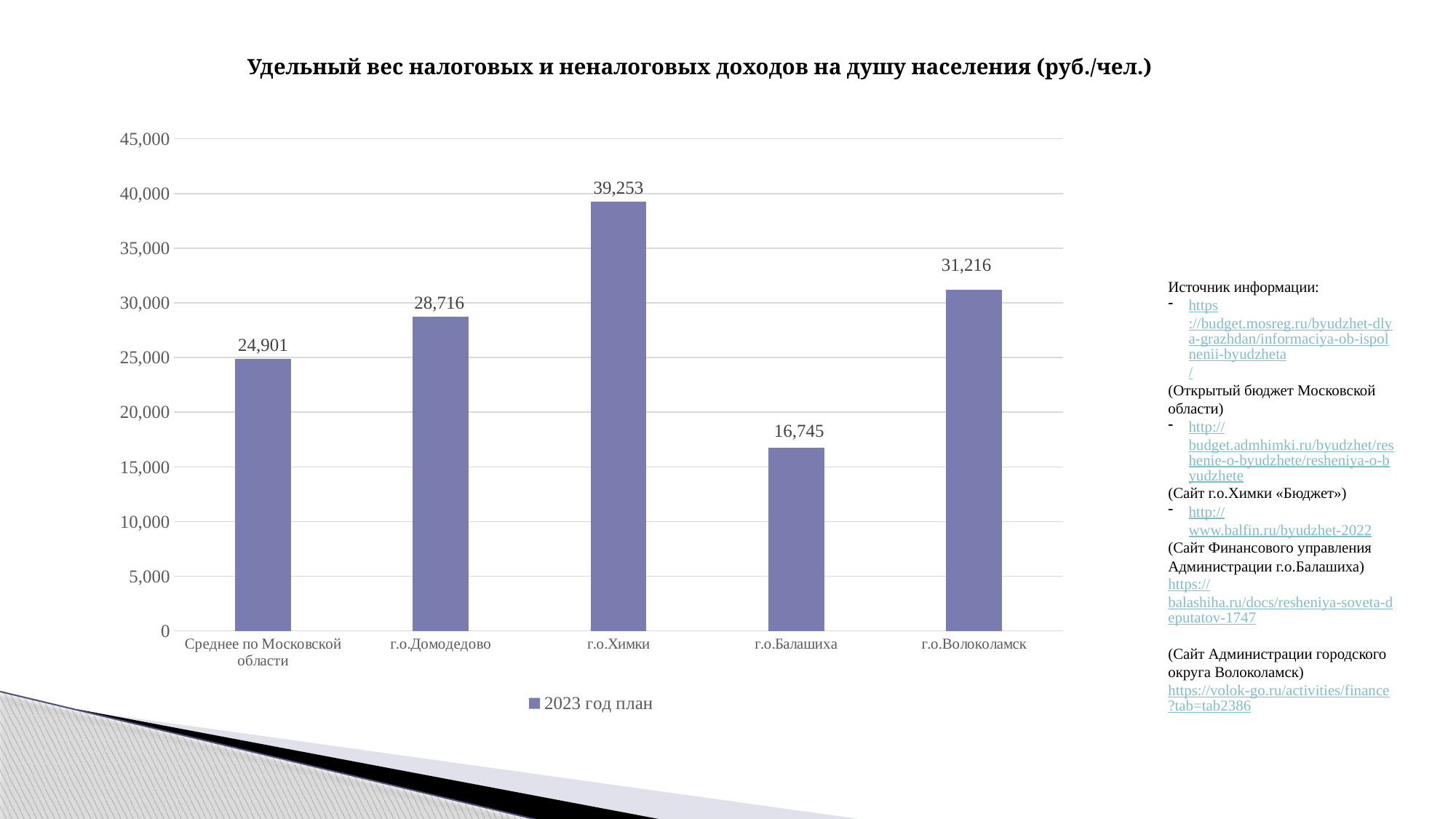
What is the value for г.о.Химки? 39,253 Which category has the lowest value? г.о.Балашиха What series does the legend list? 2023 год план What kind of chart is shown on the slide? bar chart What is the value for г.о.Балашиха? 16,745 How many categories are shown on the x axis? 5 Which is larger: the value for г.о.Волоколамск or the value for г.о.Домодедово? г.о.Волоколамск Is the value for г.о.Домодедово greater or less than 30,000? less What is the difference between the values for г.о.Волоколамск and г.о.Домодедово? 2,500 What is the value for Среднее по Московской области? 24,901 Which category has the highest value? г.о.Химки What is the difference between the values for г.о.Химки and г.о.Балашиха? 22,508